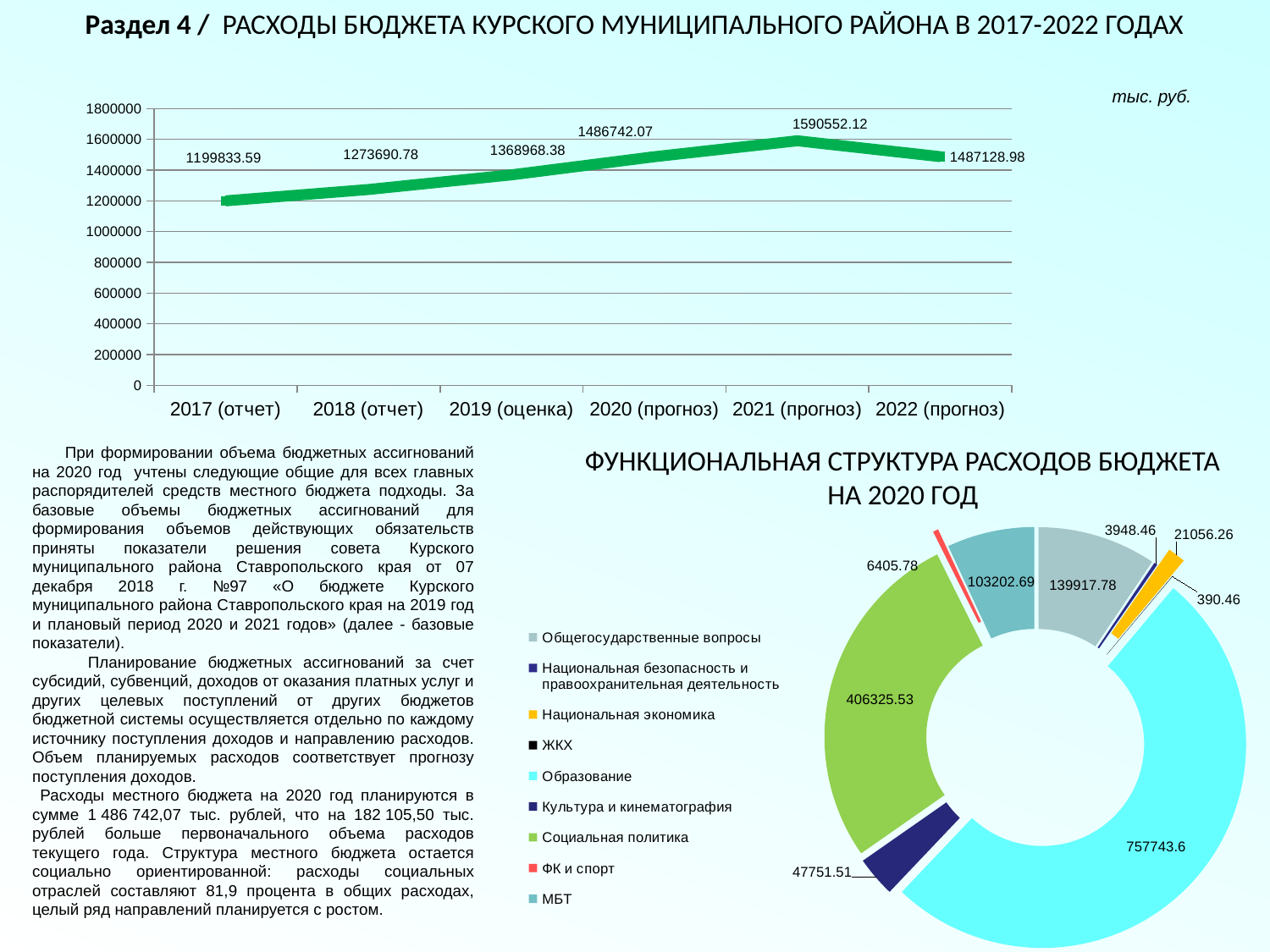
In the top line chart, how many years are plotted on the x axis? 6 In the chart 'ФУНКЦИОНАЛЬНАЯ СТРУКТУРА РАСХОДОВ БЮДЖЕТА НА 2020 ГОД', what is the value for Социальная политика? 406325.53 In the top line chart, what is the value for 2022 (прогноз)? 1487128.98 In the chart 'ФУНКЦИОНАЛЬНАЯ СТРУКТУРА РАСХОДОВ БЮДЖЕТА НА 2020 ГОД', how many categories does the legend list? 9 In the top line chart, what is the value for 2019 (оценка)? 1368968.38 What type of chart is the top chart showing budget expenditures for 2017-2022? line chart In the top line chart, what is the difference between the values for 2021 (прогноз) and 2020 (прогноз)? 103810.05 In the chart 'ФУНКЦИОНАЛЬНАЯ СТРУКТУРА РАСХОДОВ БЮДЖЕТА НА 2020 ГОД', what is the value for Образование? 757743.6 In the top line chart, do the values rise or fall from 2017 (отчет) to 2021 (прогноз)? rise In the top line chart, which year has the lowest value? 2017 (отчет) In the top line chart, which year has the highest value? 2021 (прогноз) In the chart 'ФУНКЦИОНАЛЬНАЯ СТРУКТУРА РАСХОДОВ БЮДЖЕТА НА 2020 ГОД', which category has the smallest value? ЖКХ